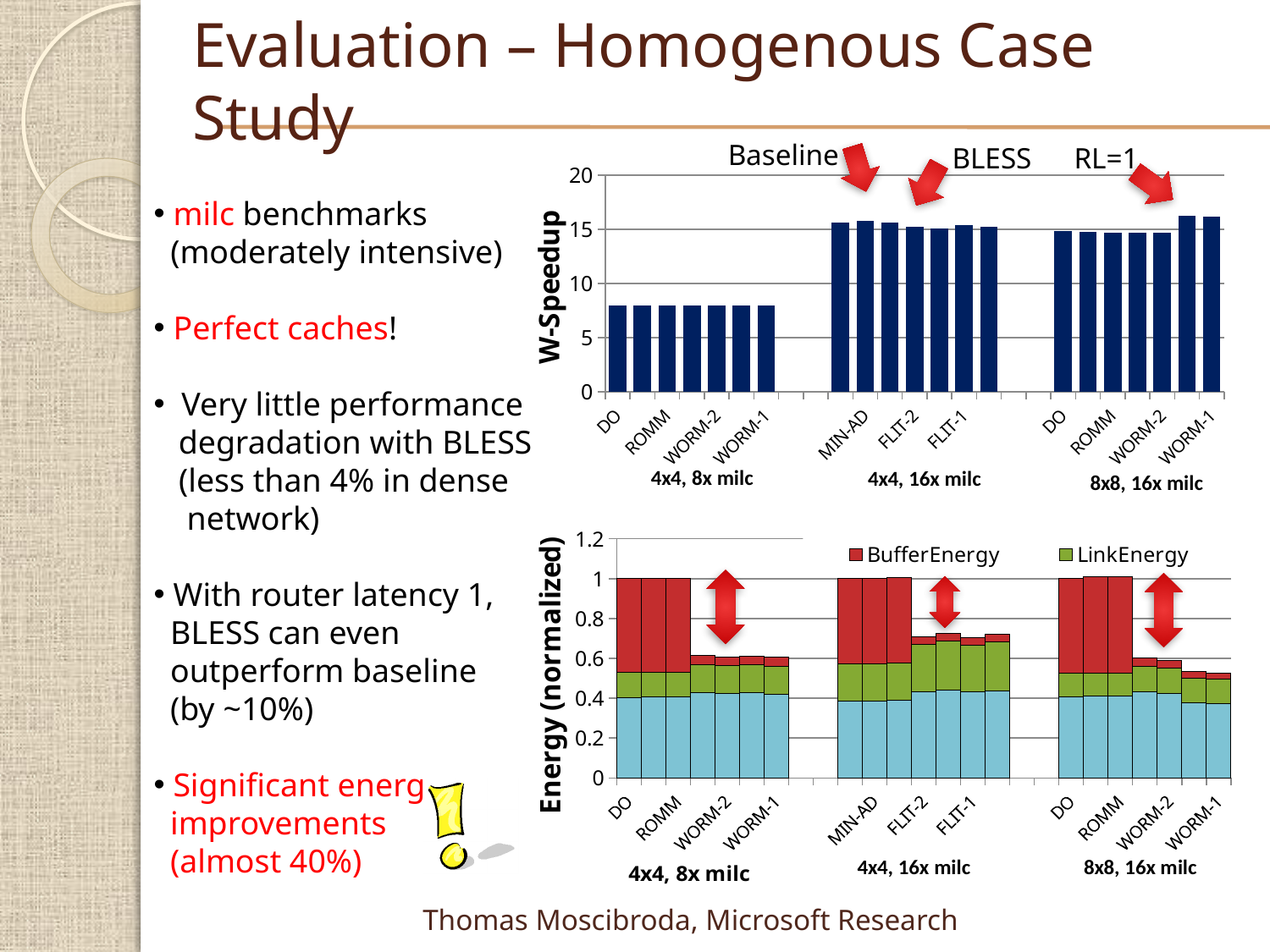
In the bottom Energy (normalized) chart, which series does the red segment represent? BufferEnergy What is the y-axis title of the top chart? W-Speedup In the top W-Speedup chart, is the value for WORM-1 in the 8x8, 16x milc group greater or less than 15? greater In the top W-Speedup chart, is the value for DO in the 4x4, 8x milc group greater or less than 10? less In the top W-Speedup chart, which is larger: DO in the 4x4, 8x milc group or DO in the 4x4, 16x milc group? DO in the 4x4, 16x milc group What kind of chart is the top chart (W-Speedup)? bar chart In the bottom Energy (normalized) chart, is the total for WORM-2 in the 4x4, 8x milc group greater or less than 0.8? less In the bottom Energy (normalized) chart, what is the total height of the DO bar in the 4x4, 8x milc group? 1 What kind of chart is the bottom chart (Energy (normalized))? stacked bar chart In the top W-Speedup chart, how many groups of bars are shown? 3